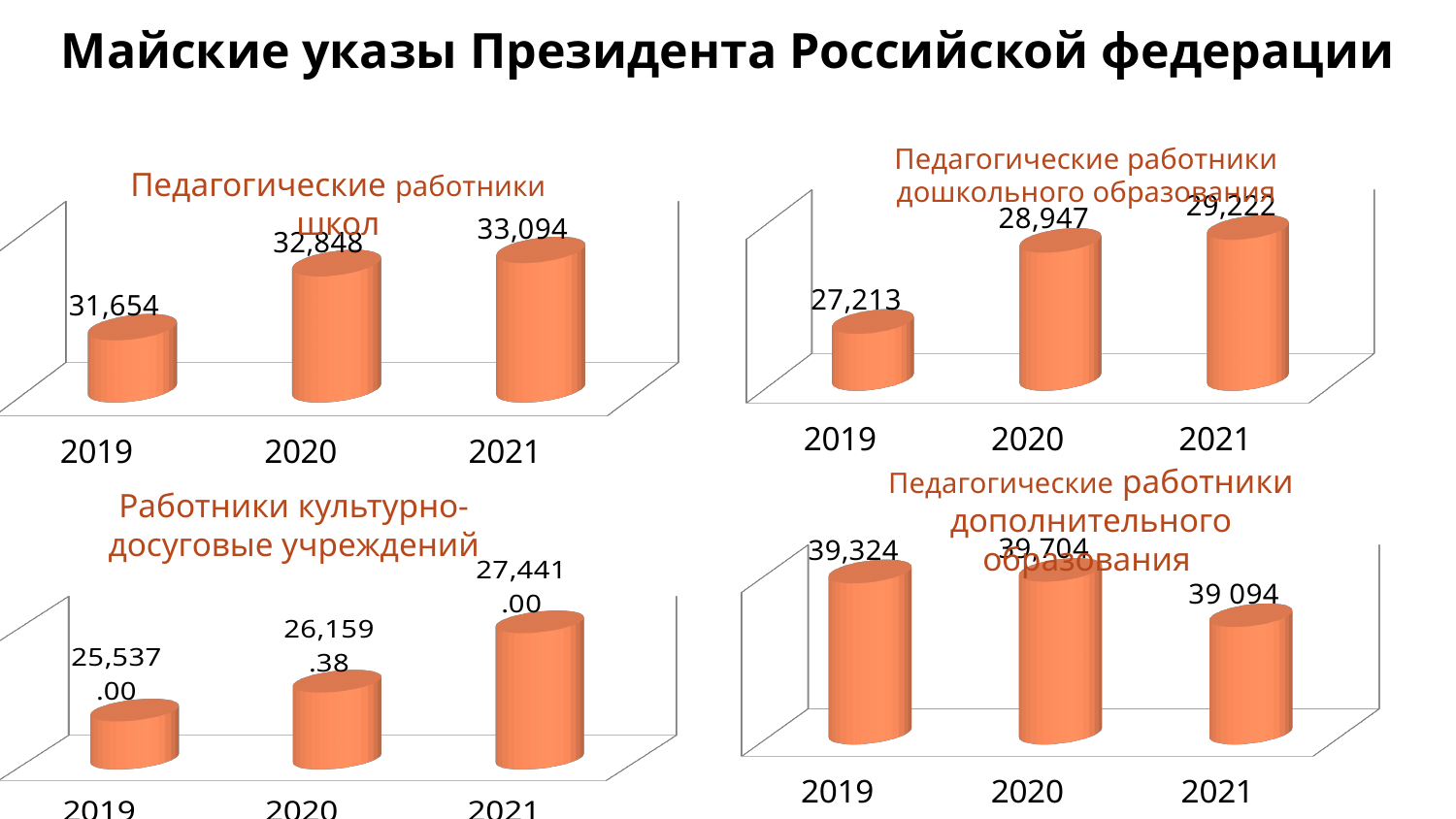
In the chart 'Работники культурно-досуговые учреждений', which is larger, the value for 2019 or the value for 2021? 2021 In the chart 'Педагогические работники школ', what is the value for 2021? 33,094 In the chart 'Педагогические работники дошкольного образования', what is the value for 2019? 27,213 In the chart 'Работники культурно-досуговые учреждений', what is the value for 2020? 26,159.38 In the chart 'Педагогические работники школ', what is the difference between the 2021 and 2019 values? 1,440 In the chart 'Педагогические работники дошкольного образования', what is the difference between the 2020 and 2019 values? 1,734 How many years are shown in the chart 'Педагогические работники дошкольного образования'? 3 In the chart 'Педагогические работники школ', which year has the lowest value? 2019 What kind of chart is 'Педагогические работники школ'? Bar chart In the chart 'Педагогические работники дополнительного образования', which year has the highest value? 2020 In the chart 'Педагогические работники школ', do the values rise or fall from 2019 to 2021? Rise In the chart 'Педагогические работники дополнительного образования', what is the value for 2021? 39 094